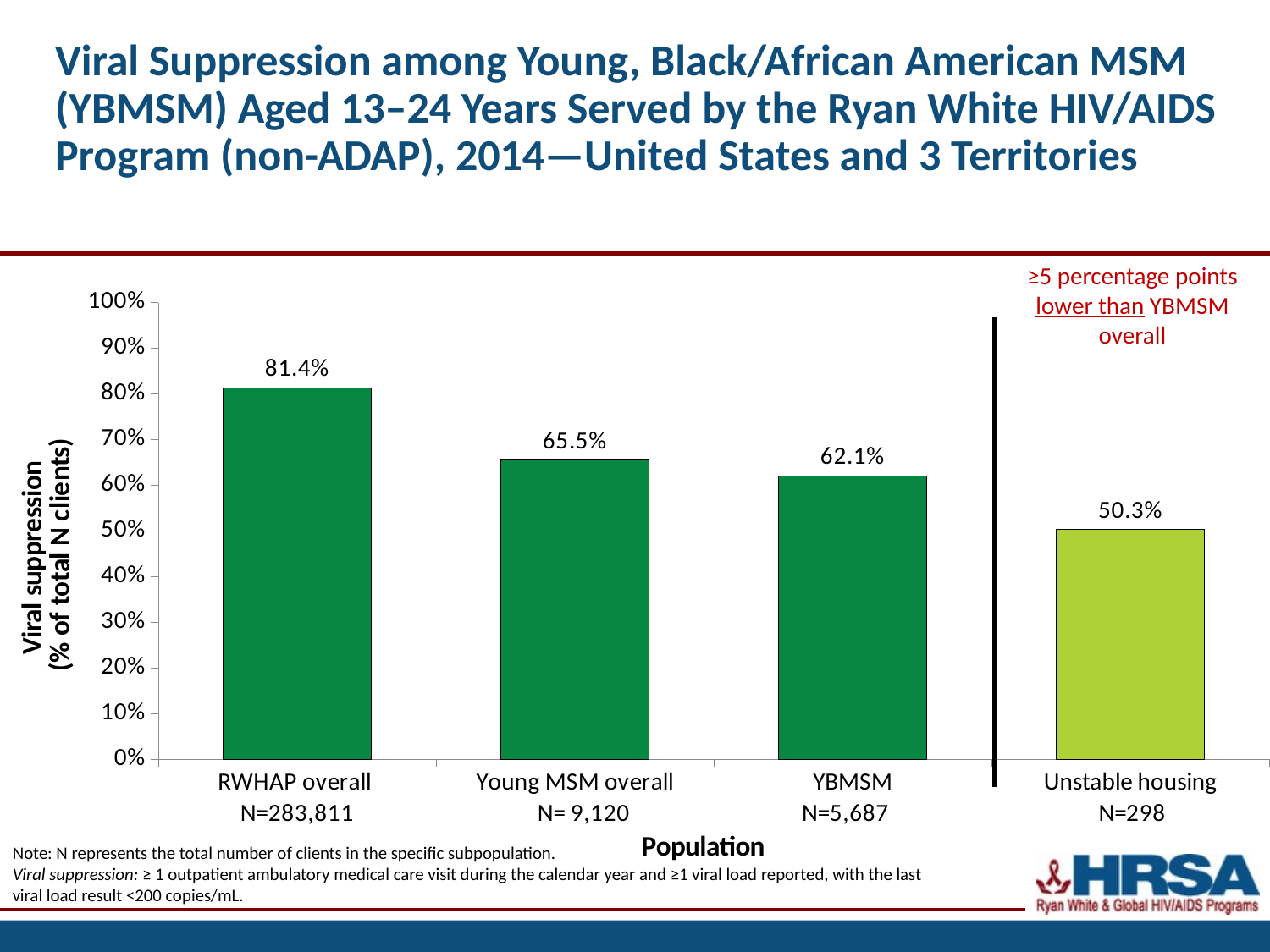
How many population categories are shown in the chart? 4 Which population has the lowest viral suppression percentage? Unstable housing Which has a higher viral suppression percentage, Young MSM overall or YBMSM? Young MSM overall What is the viral suppression percentage for RWHAP overall? 81.4% Which population has the highest viral suppression percentage? RWHAP overall What is the difference in viral suppression between RWHAP overall and YBMSM? 19.3 percentage points What is the viral suppression percentage for the Unstable housing group? 50.3% What type of chart is shown on the slide? Bar chart What is the viral suppression percentage for Young MSM overall? 65.5% What is the difference in viral suppression between YBMSM and the Unstable housing group? 11.8 percentage points What is the viral suppression percentage for YBMSM? 62.1% What is the N (number of clients) shown for the YBMSM category? N=5,687